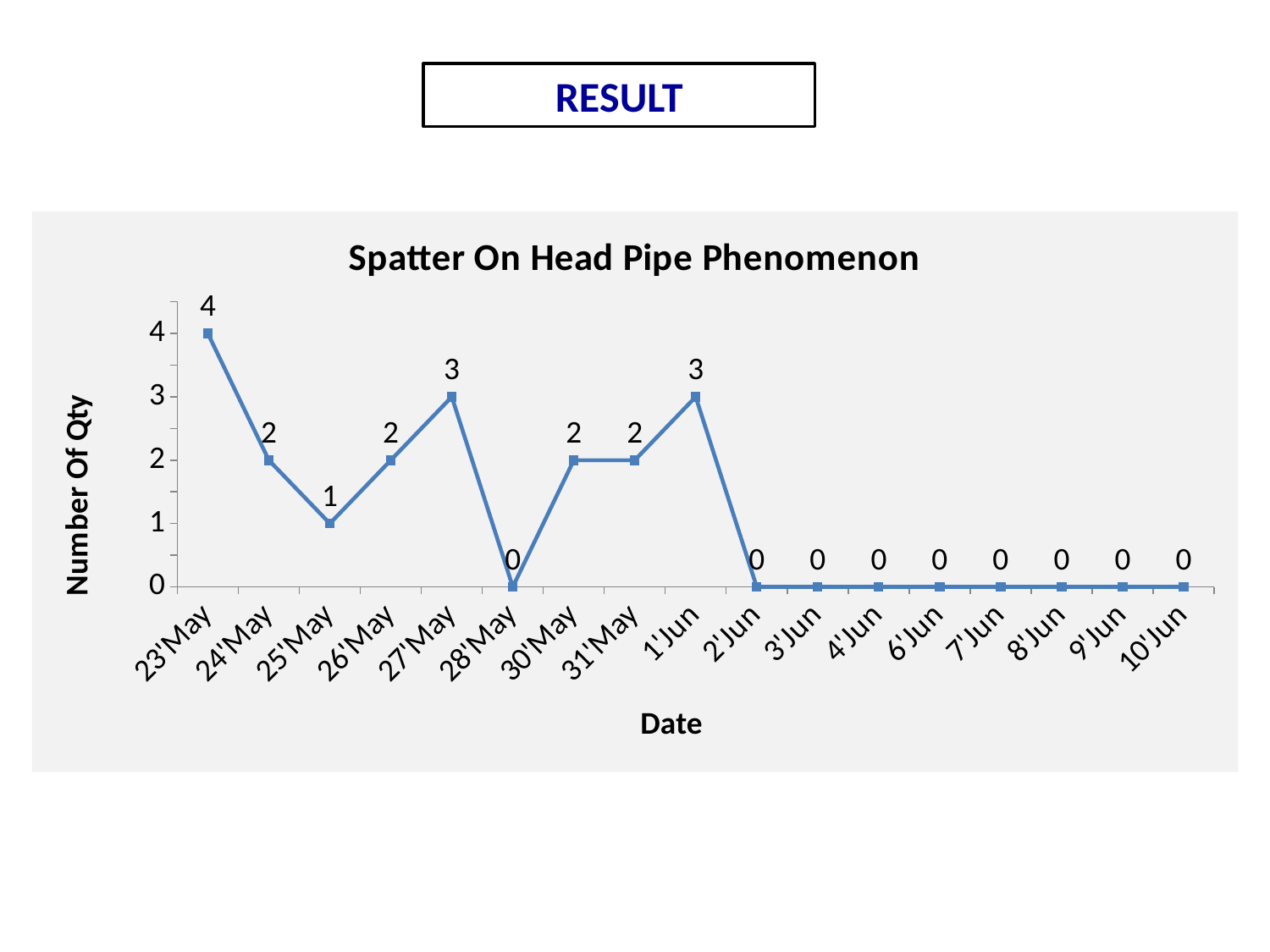
How many dates are plotted on the x axis? 17 What is the difference between the values for 23'May and 24'May? 2 What is the label of the y axis? Number Of Qty What is the value for 27'May? 3 Which date has the highest value? 23'May Which is larger, the value for 26'May or the value for 1'Jun? 1'Jun What is the value for 25'May? 1 What kind of chart is this? line chart What is the title of the chart? Spatter On Head Pipe Phenomenon What is the value for 23'May? 4 What is the value for 28'May? 0 Do the values rise or fall from 23'May to 25'May? fall